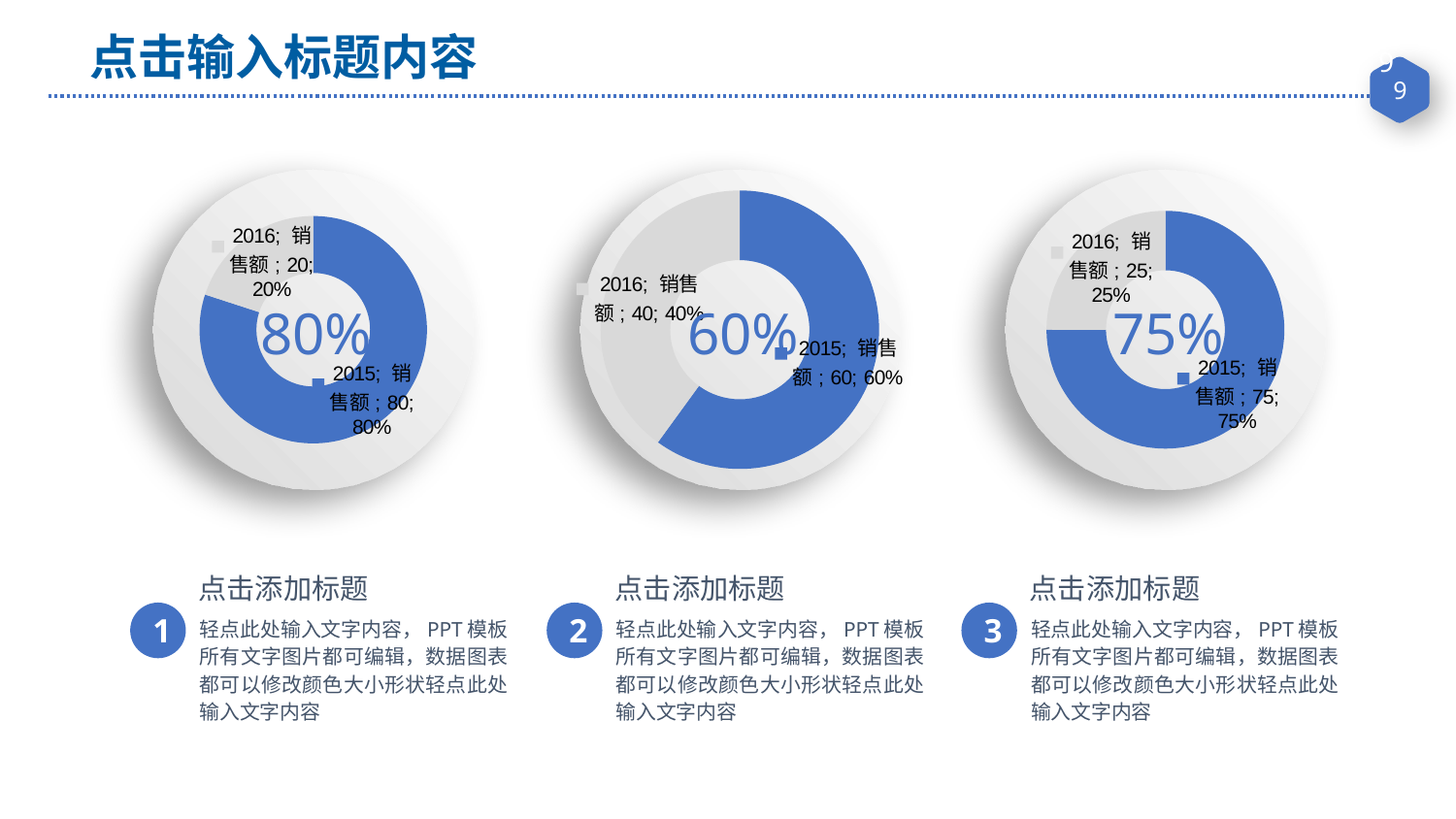
In the left chart, what is the 销售额 value for 2015? 80 In the right chart, what is the difference between the 2015 and 2016 销售额 values? 50 In the middle chart, which year has the smaller 销售额 value? 2016 In the middle chart, what percentage share does 2015 have? 60% In the left chart, what percentage share does 2016 have? 20% In the right chart, what is the 销售额 value for 2015? 75 In the right chart, what percentage share does 2016 have? 25% In the left chart, which year has the larger 销售额 value? 2015 What kind of chart is the left chart? Doughnut chart In the middle chart, what is the difference between the 2015 and 2016 销售额 values? 20 In the middle chart, what is the 销售额 value for 2016? 40 How many charts are shown on the slide? 3